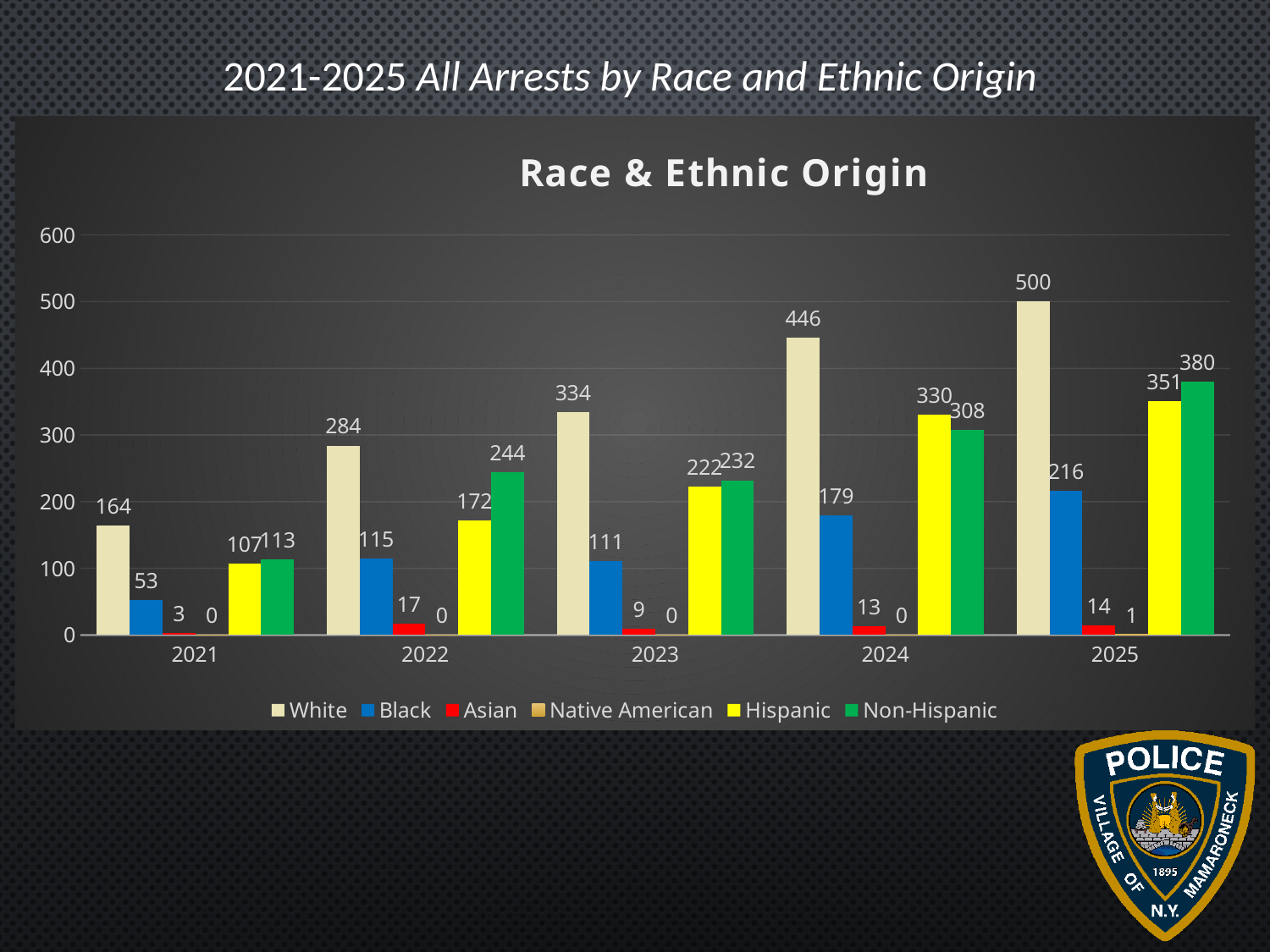
What is the difference between the Non-Hispanic and Hispanic values in 2025? 29 What is the value for White in 2025? 500 What is the value for Asian in 2024? 13 What is the value for Hispanic in 2022? 172 Which year has the highest value for White? 2025 What is the value for Black in 2023? 111 How many years are shown on the x axis? 5 Which year has the lowest value for Non-Hispanic? 2021 What kind of chart is shown? Bar chart Which is larger in 2024, the Hispanic value or the Non-Hispanic value? Hispanic Do the White values rise or fall from 2021 to 2025? Rise How many series does the legend list? 6